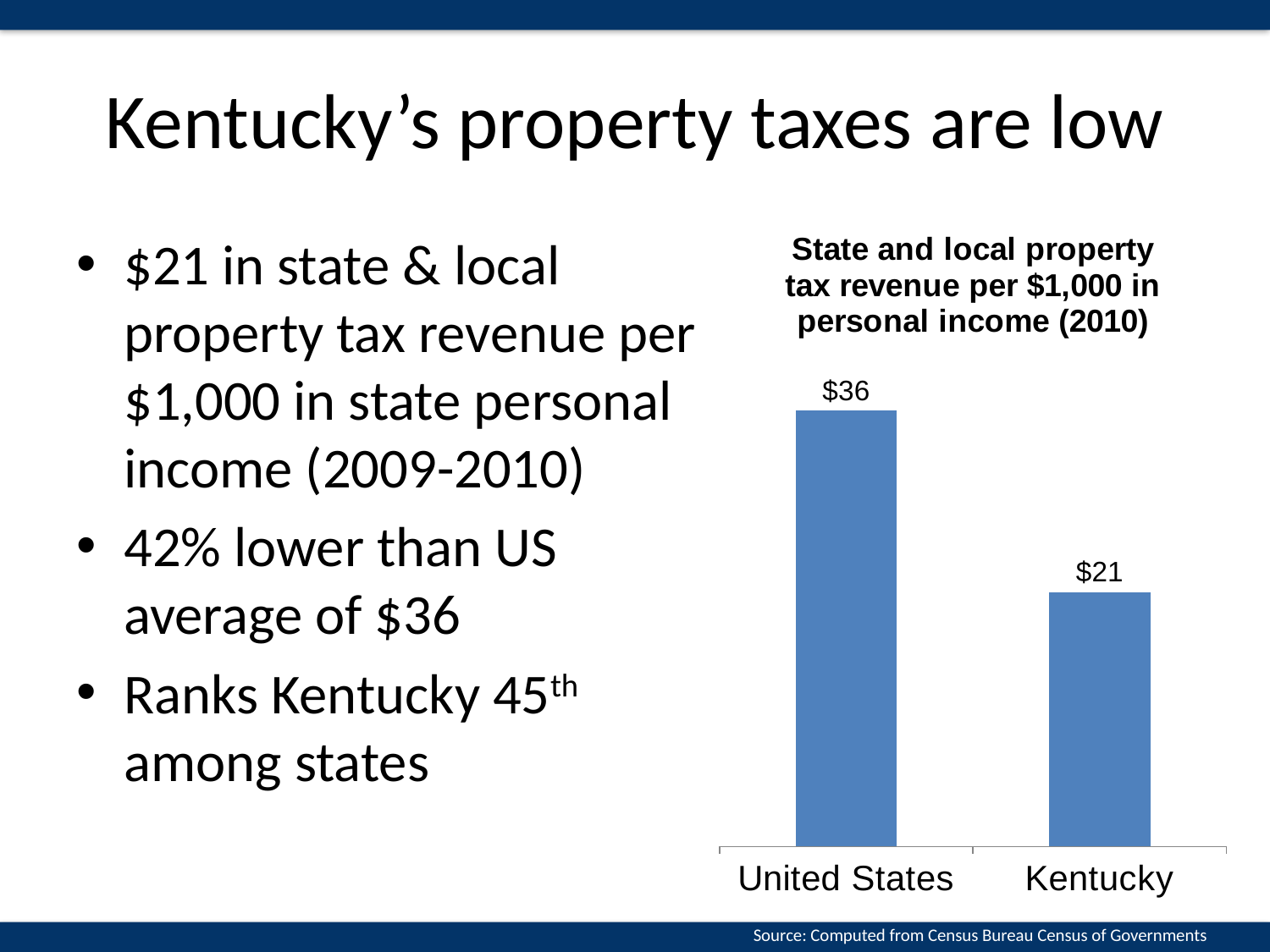
How many categories are shown in the chart? 2 What colour are the bars in the chart? Blue Which category has the highest value in the chart? United States What is the value for United States in the chart? $36 Which is larger, the value for United States or the value for Kentucky? United States What is the difference between the United States value and the Kentucky value? $15 What is the title of the chart? State and local property tax revenue per $1,000 in personal income (2010) What kind of chart is shown on the slide? Bar chart Do the values rise or fall from left to right across the chart? Fall What is the value for Kentucky in the chart? $21 Which category has the lowest value in the chart? Kentucky